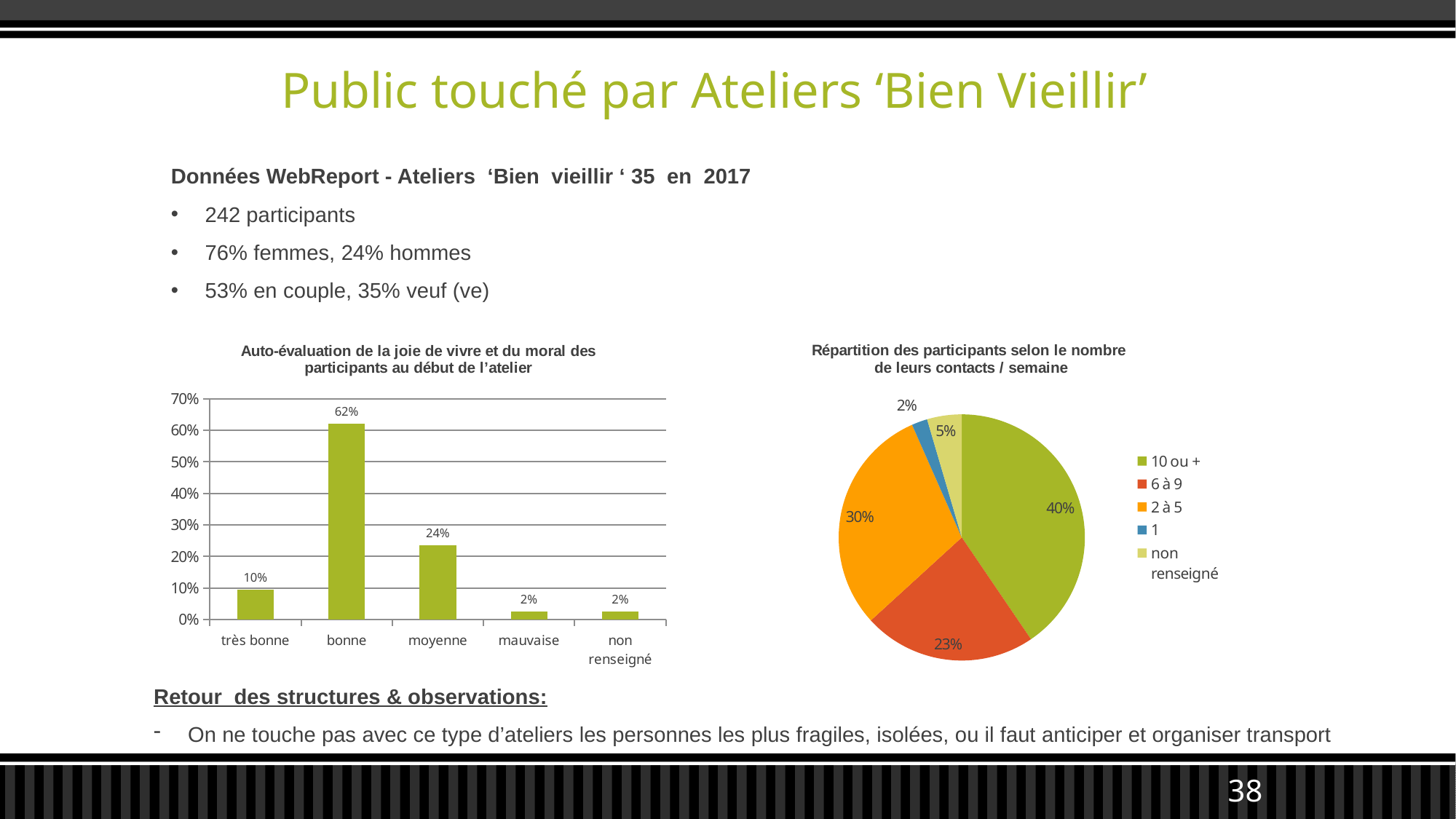
What kind of chart is the chart on the right of the slide? pie chart In the bar chart on the left, what is the difference between the values for 'bonne' and 'moyenne'? 38% In the pie chart on the right, which category has the smallest share? 1 In the bar chart 'Auto-évaluation de la joie de vivre et du moral des participants au début de l'atelier', what is the value for 'bonne'? 62% In the pie chart on the right, what share do participants with '2 à 5' contacts represent? 30% In the bar chart on the left, which category has the highest value? bonne In the bar chart 'Auto-évaluation de la joie de vivre et du moral des participants au début de l'atelier', what is the value for 'moyenne'? 24% What kind of chart is the chart on the left of the slide? bar chart In the pie chart 'Répartition des participants selon le nombre de leurs contacts / semaine', what share do participants with '10 ou +' contacts represent? 40% How many entries does the legend of the pie chart on the right list? 5 In the bar chart on the left, which is larger, the value for 'très bonne' or the value for 'moyenne'? moyenne How many categories are shown in the bar chart on the left? 5